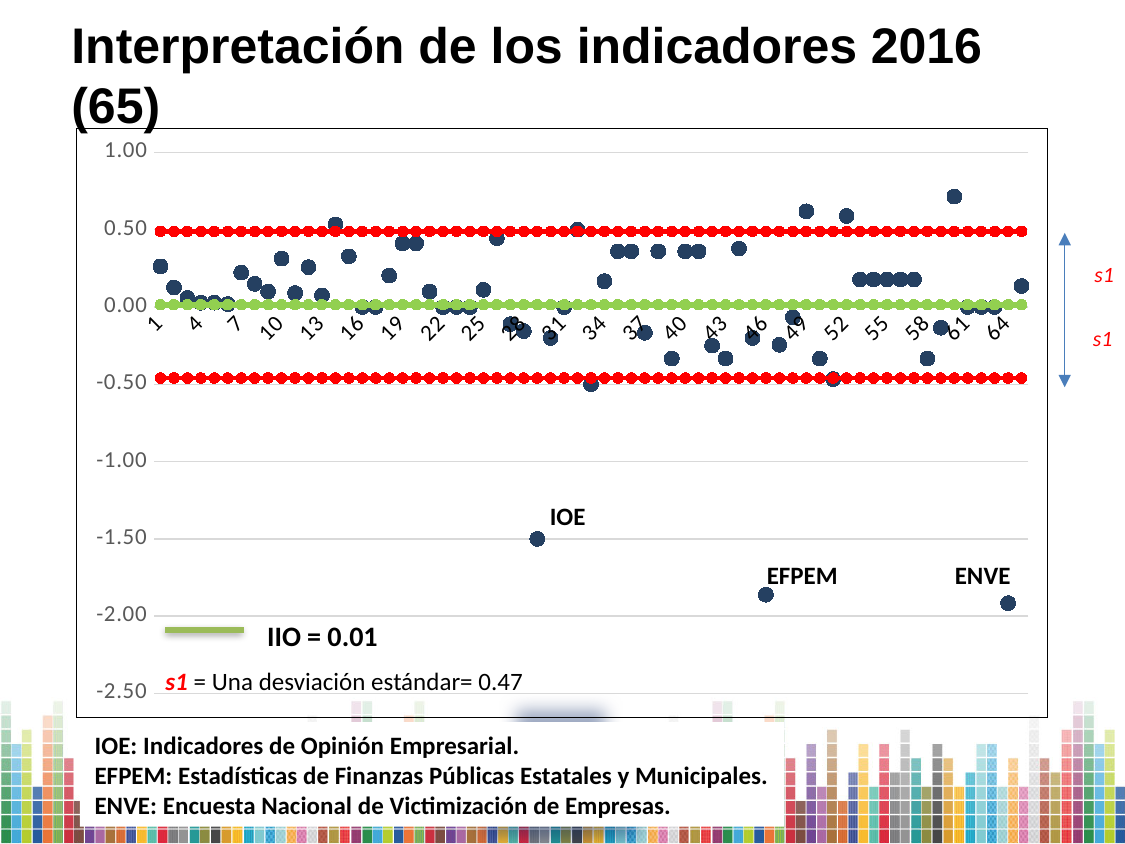
What kind of chart is shown on the slide? scatter chart Which labeled indicator has the lowest value in the chart? ENVE What does s1 stand for according to the chart note? Una desviación estándar How many indicators does the slide title say are interpreted? 65 What colour is the horizontal line representing IIO? green Which of the two labeled points, IOE or ENVE, has the higher value? IOE What is the lowest value shown on the vertical axis? -2.50 Is the value for EFPEM greater or less than -2.00? greater According to the chart, what is the value of one standard deviation (s1)? 0.47 What is the value of IIO shown in the chart legend? 0.01 Is the value for IOE greater or less than -1.00? less Is the value for ENVE greater or less than -1.50? less